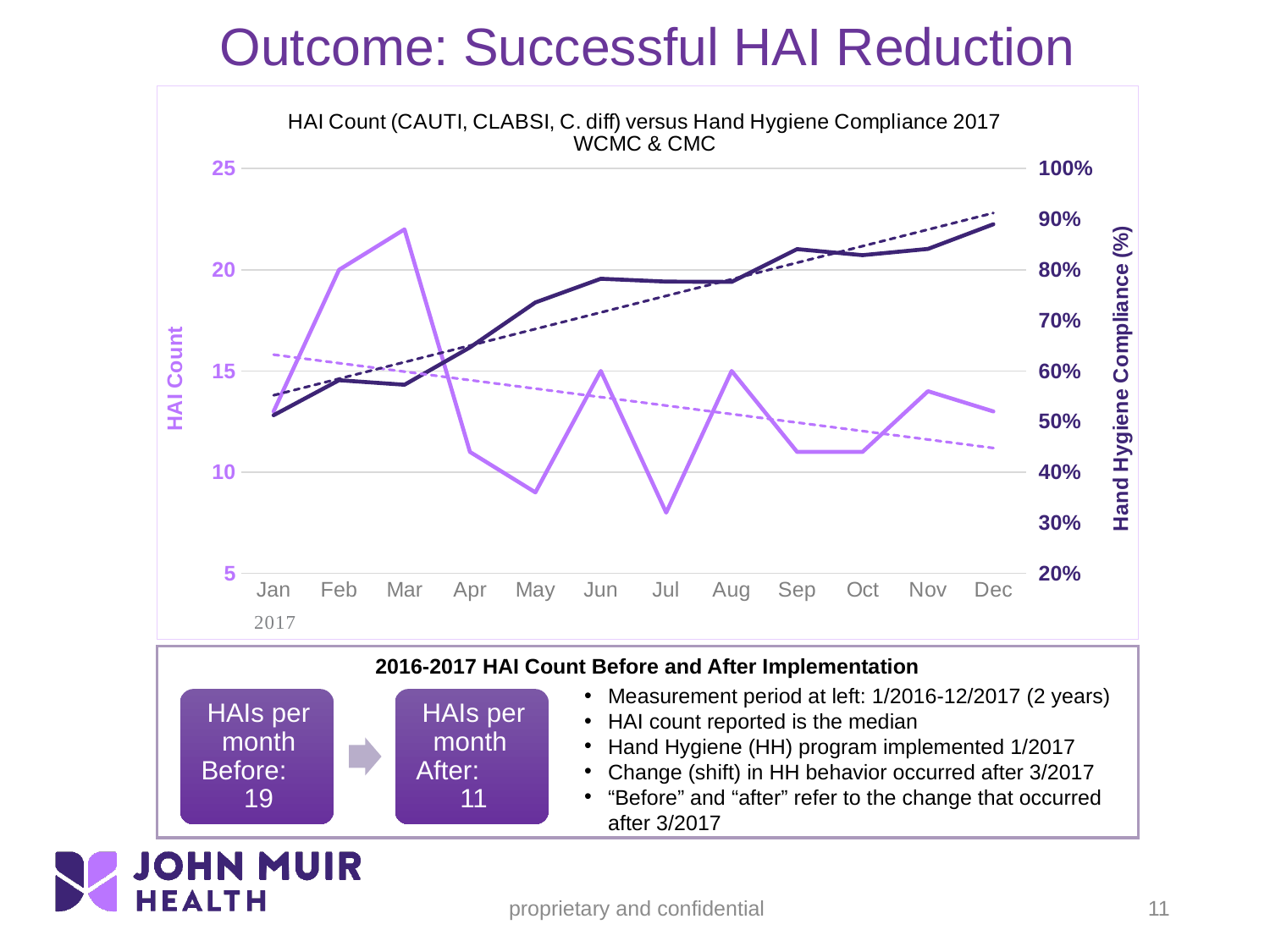
Is the HAI Count for Jul greater or less than 10? less In which month is Hand Hygiene Compliance lowest? Jan Is the HAI Count for Mar greater or less than 20? greater What is the title of the chart? HAI Count (CAUTI, CLABSI, C. diff) versus Hand Hygiene Compliance 2017 WCMC & CMC What is the label of the right-hand vertical axis? Hand Hygiene Compliance (%) In which month is Hand Hygiene Compliance highest? Dec Does Hand Hygiene Compliance generally rise or fall from Jan to Dec? rise In which month is the HAI Count lowest? Jul Is the Hand Hygiene Compliance for Dec greater or less than 80%? greater What kind of chart is shown on the slide? line chart How many months are plotted along the x axis of the chart? 12 In which month is the HAI Count highest? Mar